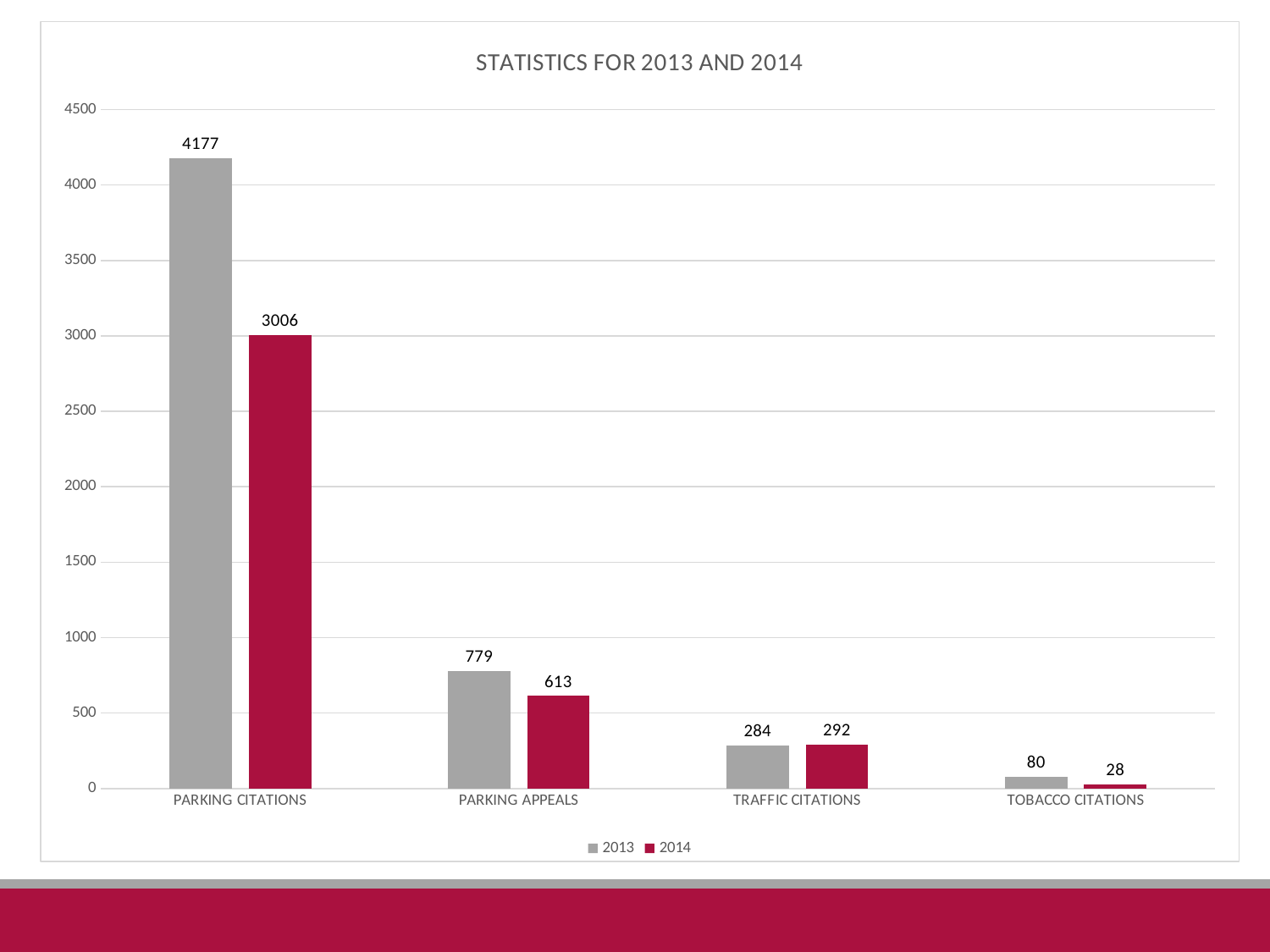
What kind of chart is shown on the slide? Bar chart Which category has the highest value for 2014? Parking Citations What is the difference between the 2013 and 2014 values for Parking Appeals? 166 What is the difference between the 2013 and 2014 values for Parking Citations? 1171 How many series does the legend list? 2 How many categories are shown on the x axis? 4 What is the title of the chart? STATISTICS FOR 2013 AND 2014 What is the value for Parking Appeals in 2014? 613 Which is larger for Traffic Citations, the 2013 value or the 2014 value? 2014 What is the value for Tobacco Citations in 2014? 28 Which category has the lowest value for 2013? Tobacco Citations What is the value for Parking Citations in 2013? 4177